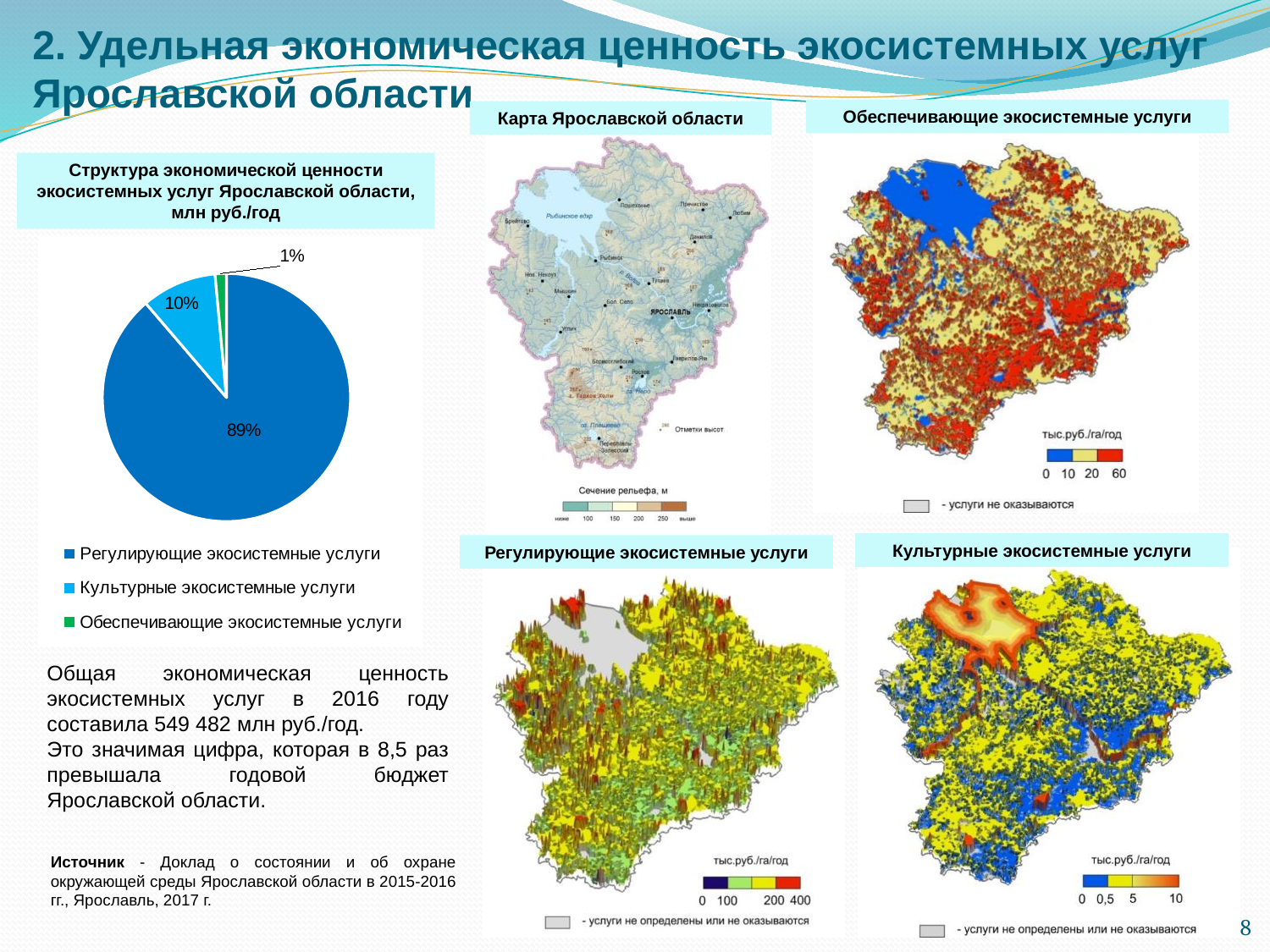
What type of chart is shown on the left of the slide? Pie chart On the pie chart, what is the difference in percentage points between Регулирующие and Культурные экосистемные услуги? 79 On the pie chart, what share is shown for Обеспечивающие экосистемные услуги? 1% On the pie chart, what share is shown for Культурные экосистемные услуги? 10% What is the title of the pie chart? Структура экономической ценности экосистемных услуг Ярославской области, млн руб./год How many slices does the pie chart have? 3 On the pie chart, what colour is the slice for Обеспечивающие экосистемные услуги? Green On the pie chart, which category has the smallest share? Обеспечивающие экосистемные услуги On the pie chart, which category has the largest share? Регулирующие экосистемные услуги On the pie chart, which is larger: the share for Культурные экосистемные услуги or for Обеспечивающие экосистемные услуги? Культурные экосистемные услуги How many entries does the legend of the pie chart list? 3 On the pie chart, what share is shown for Регулирующие экосистемные услуги? 89%